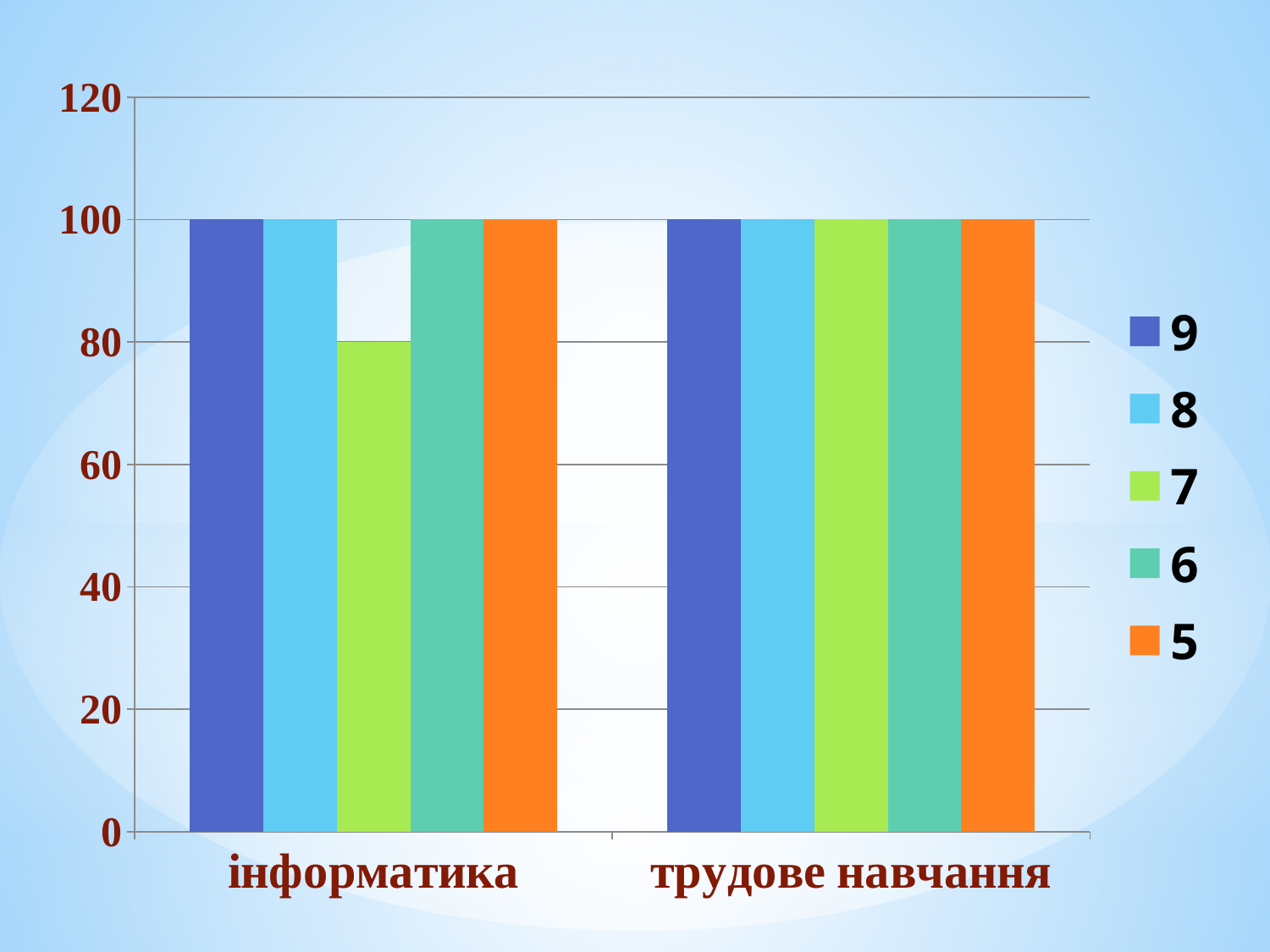
What colour are the bars for series 5? orange How many categories are shown on the x axis? 2 Which is larger: the value for series 7 in інформатика or the value for series 7 in трудове навчання? трудове навчання How many series does the legend list? 5 Which series has the lowest value in the інформатика category? 7 What is the value for series 5 in the трудове навчання category? 100 Is the value for series 7 in інформатика greater or less than 100? less What kind of chart is shown on the slide? bar chart What is the value for series 9 in the інформатика category? 100 What is the value for series 7 in the трудове навчання category? 100 What is the difference between the value for series 7 in трудове навчання and the value for series 7 in інформатика? 20 What is the value for series 7 in the інформатика category? 80